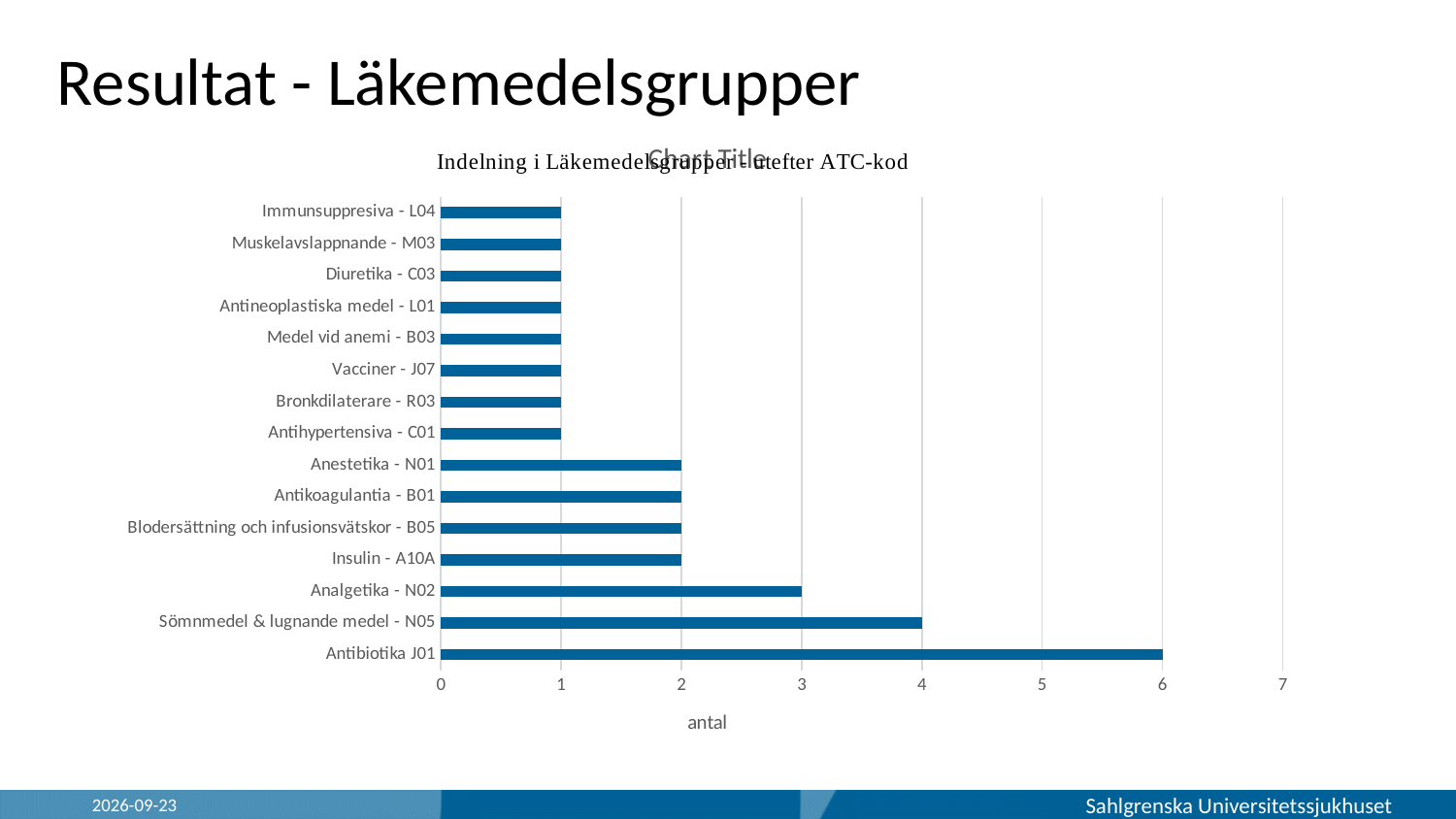
What is the value for Insulin - A10A? 2 What is the value for Sömnmedel & lugnande medel - N05? 4 Is the value for Antibiotika J01 greater or less than 5? greater What is the value for Vacciner - J07? 1 How many drug groups (categories) are plotted in the chart? 15 Which is larger, the value for Analgetika - N02 or the value for Anestetika - N01? Analgetika - N02 What is the value for Antibiotika J01? 6 What is the label on the horizontal axis of the chart? antal What is the difference between the values for Antibiotika J01 and Sömnmedel & lugnande medel - N05? 2 What type of chart is shown on the slide? Bar chart What is the value for Analgetika - N02? 3 Which category has the highest value? Antibiotika J01